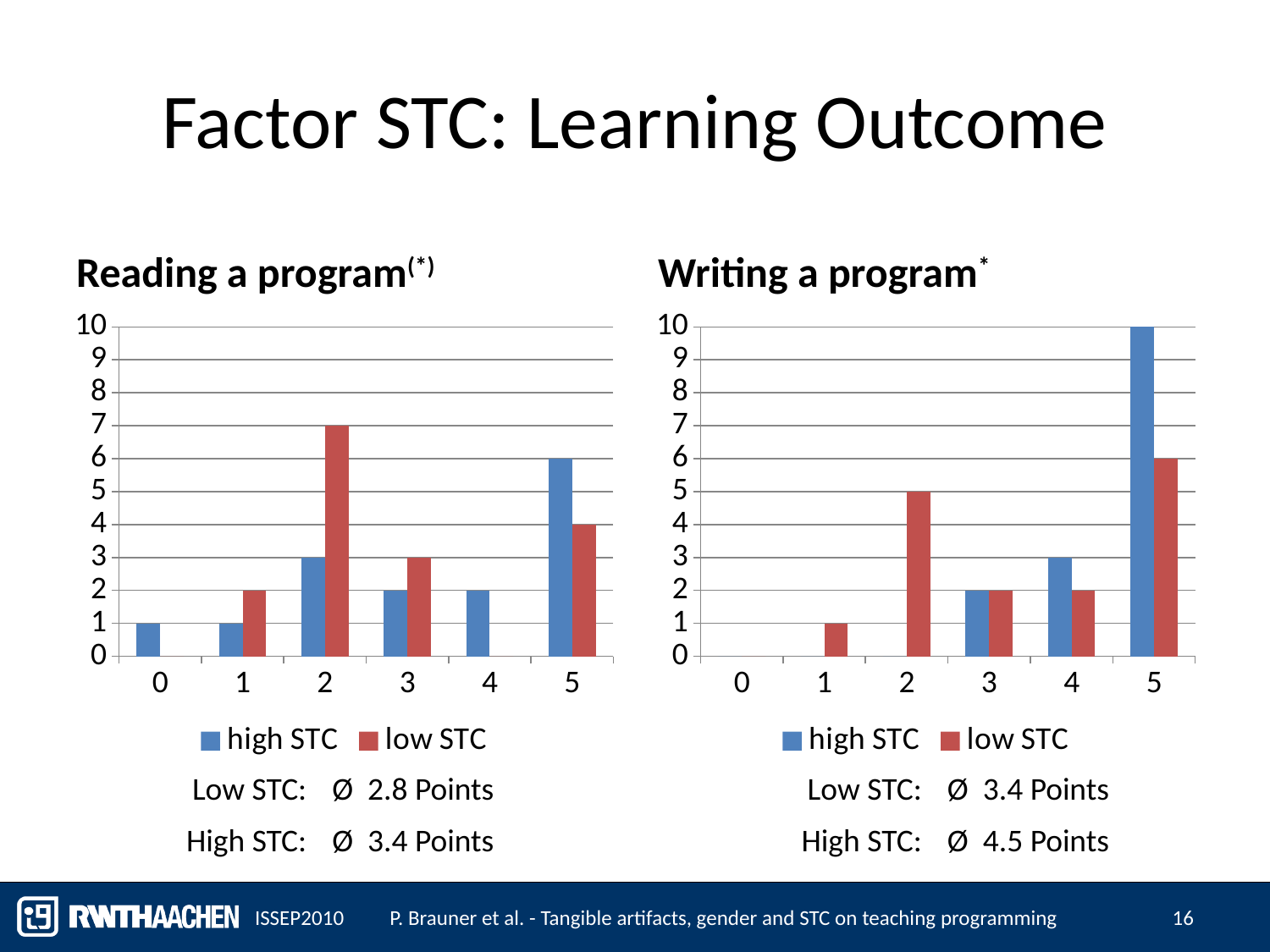
In the 'Writing a program' chart, is the high STC bar at score 5 greater or less than 8? greater In the 'Reading a program' chart, which is larger at score 3: the high STC bar or the low STC bar? low STC In the 'Reading a program' chart, what is the value of the low STC bar at score 2? 7 What kind of chart is the 'Writing a program' chart? bar chart How many series does the legend of the 'Reading a program' chart list? 2 How many score categories are shown on the x axis of the 'Reading a program' chart? 6 In the 'Writing a program' chart, what is the value of the high STC bar at score 5? 10 In the 'Writing a program' chart, what is the value of the low STC bar at score 2? 5 In the 'Writing a program' chart, at which score is the high STC bar highest? 5 In the 'Writing a program' chart, what is the difference between the high STC and low STC bars at score 5? 4 In the 'Reading a program' chart, what is the value of the high STC bar at score 5? 6 In the 'Reading a program' chart, at which score is the low STC bar highest? 2